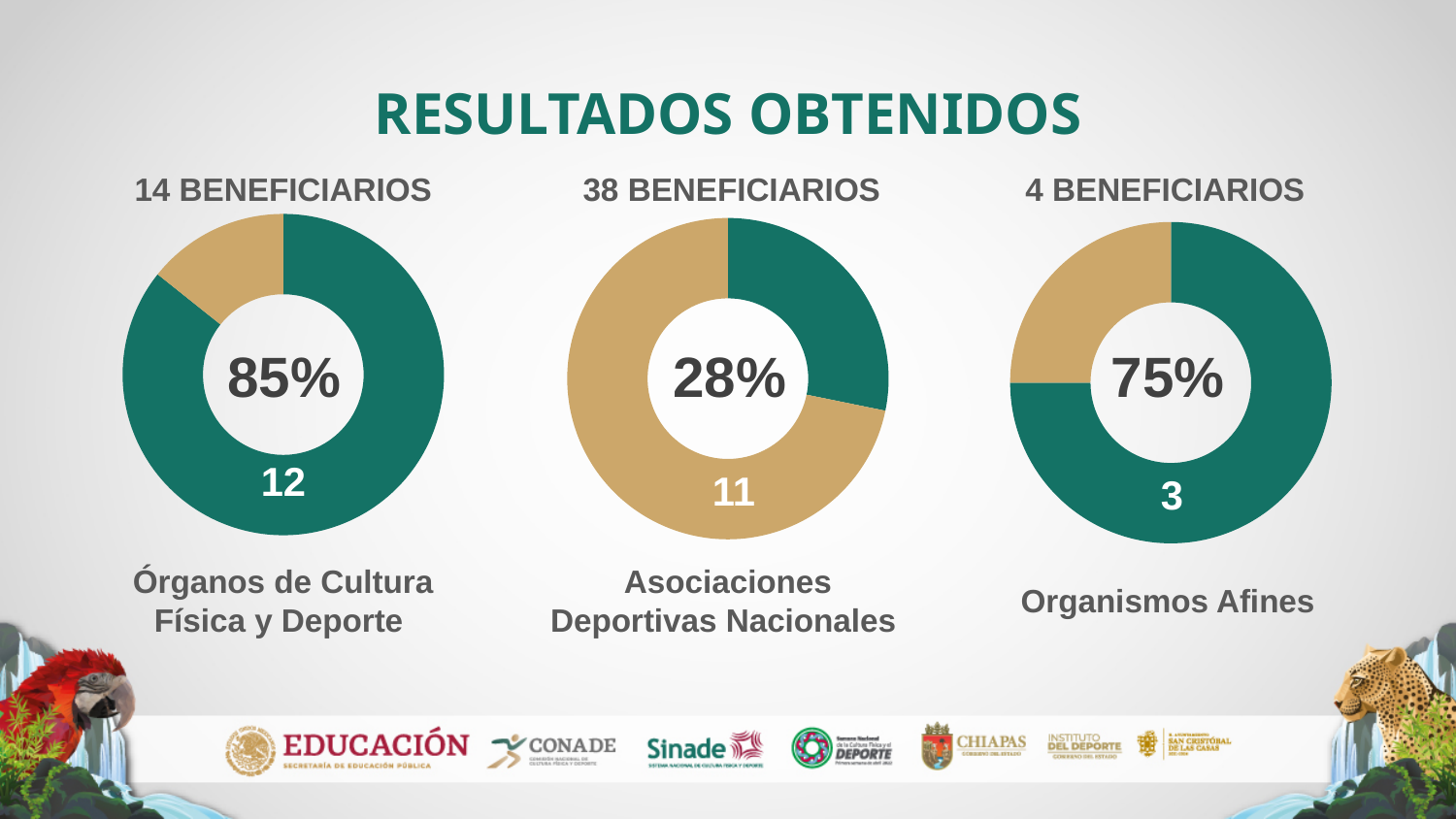
What kind of chart is used for each of the three groups on the slide? Donut (pie) chart What percentage is shown in the centre of the chart titled "4 BENEFICIARIOS" (Organismos Afines)? 75% What percentage is shown in the centre of the chart titled "14 BENEFICIARIOS" (Órganos de Cultura Física y Deporte)? 85% What share of the Organismos Afines chart does the green segment represent? 75% Is the percentage for Asociaciones Deportivas Nacionales larger or smaller than the percentage for Organismos Afines? smaller What percentage is shown in the centre of the chart titled "38 BENEFICIARIOS" (Asociaciones Deportivas Nacionales)? 28% In the chart for Organismos Afines, what number is printed on the green segment? 3 Which of the three charts shows the lowest percentage in its centre? 38 BENEFICIARIOS (Asociaciones Deportivas Nacionales) Which of the three charts shows the highest percentage in its centre? 14 BENEFICIARIOS (Órganos de Cultura Física y Deporte) In the chart for Órganos de Cultura Física y Deporte, what number is printed on the green segment? 12 How many charts are shown on the slide? 3